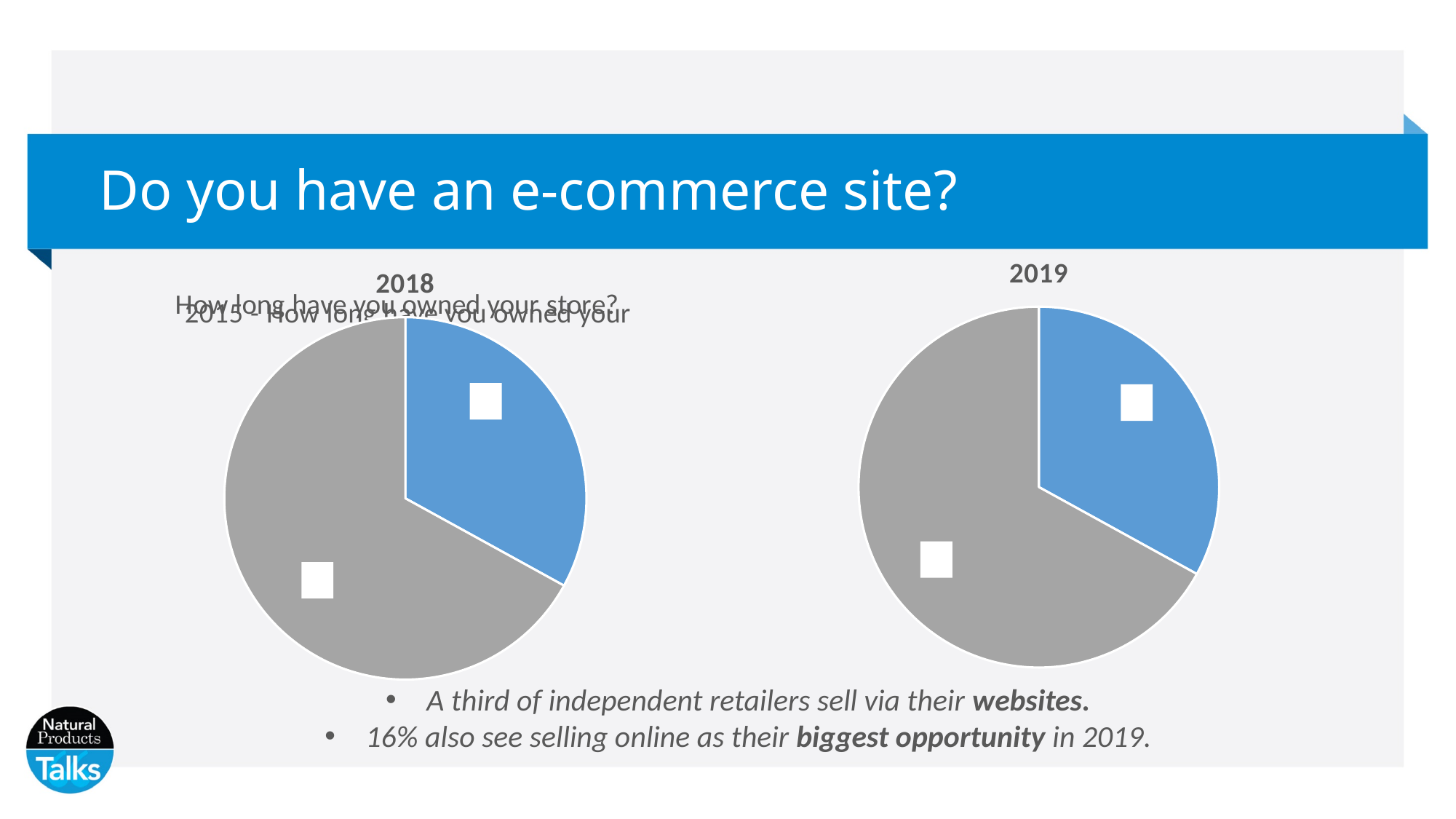
In the 2018 pie chart, which slice is larger, the blue one or the grey one? grey What kind of chart is the 2018 chart on the left? pie chart How many slices does the 2018 pie chart have? 2 What kind of chart is the 2019 chart on the right? pie chart In the 2018 pie chart, which slice is the smallest? the blue slice In the 2019 pie chart, which slice is larger, the blue one or the grey one? grey How many slices does the 2019 pie chart have? 2 What is the title of the pie chart on the left? 2018 How many charts are shown on the slide? 2 What is the title of the pie chart on the right? 2019